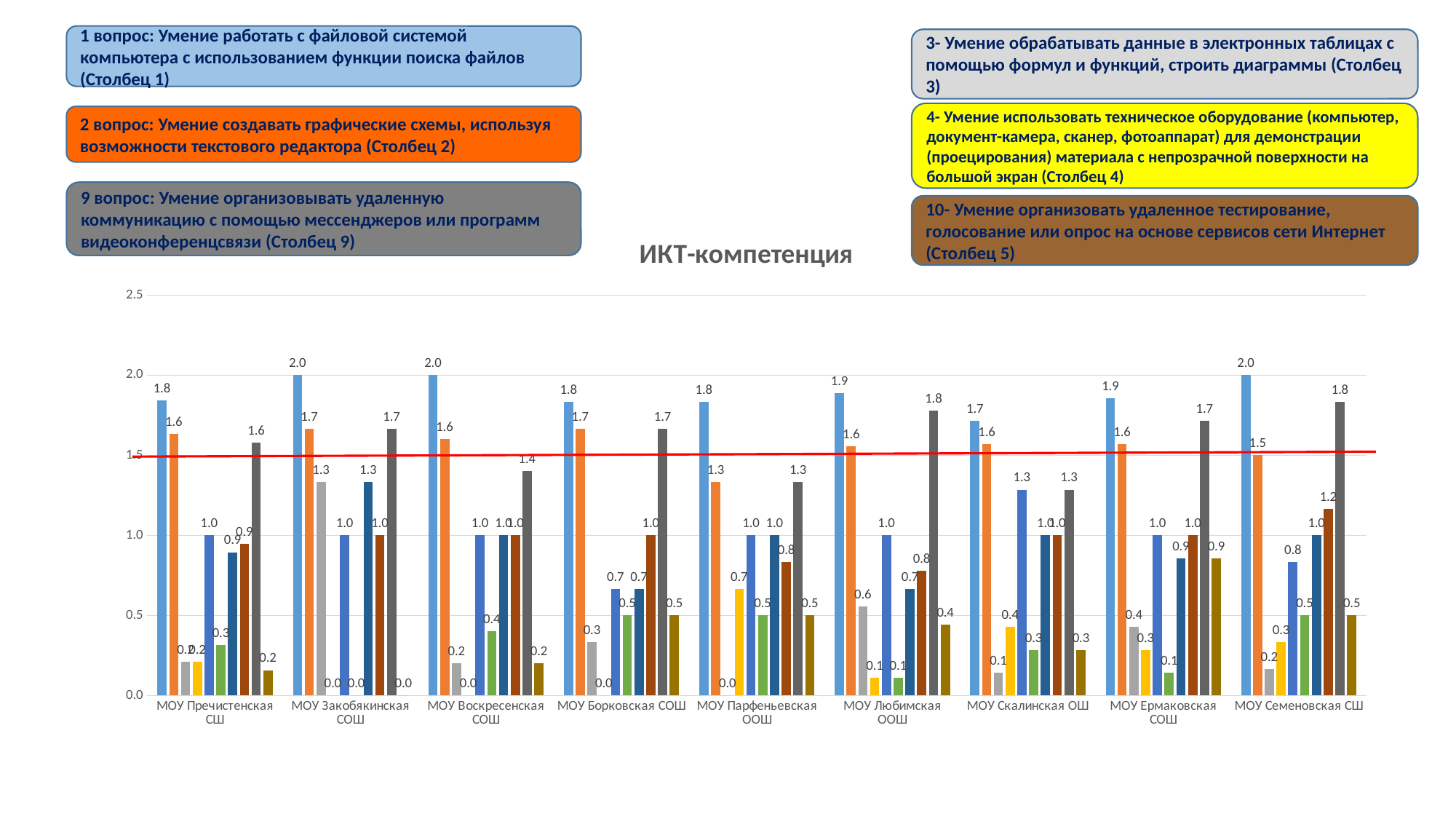
What is the title of the chart? ИКТ-компетенция What is the value of the second (orange) bar for МОУ Ермаковская СОШ? 1.6 Which school has the lowest value for the first (light blue) bar? МОУ Скалинская ОШ What is the value of the dark gray bar for МОУ Семеновская СШ? 1.8 Which is larger: the first (light blue) bar for МОУ Любимская ООШ or for МОУ Борковская СОШ? МОУ Любимская ООШ What kind of chart is shown on the slide? bar chart What is the value of the first (light blue) bar for МОУ Закобякинская СОШ? 2.0 What colour is the horizontal reference line drawn across the chart? red What is the difference between the first (light blue) bar and the second (orange) bar for МОУ Пречистенская СШ? 0.2 Is the second (orange) bar for МОУ Парфеньевская ООШ greater or less than 1.5? less How many schools (categories) are shown on the x axis of the chart? 9 What is the value of the first (light blue) bar for МОУ Скалинская ОШ? 1.7